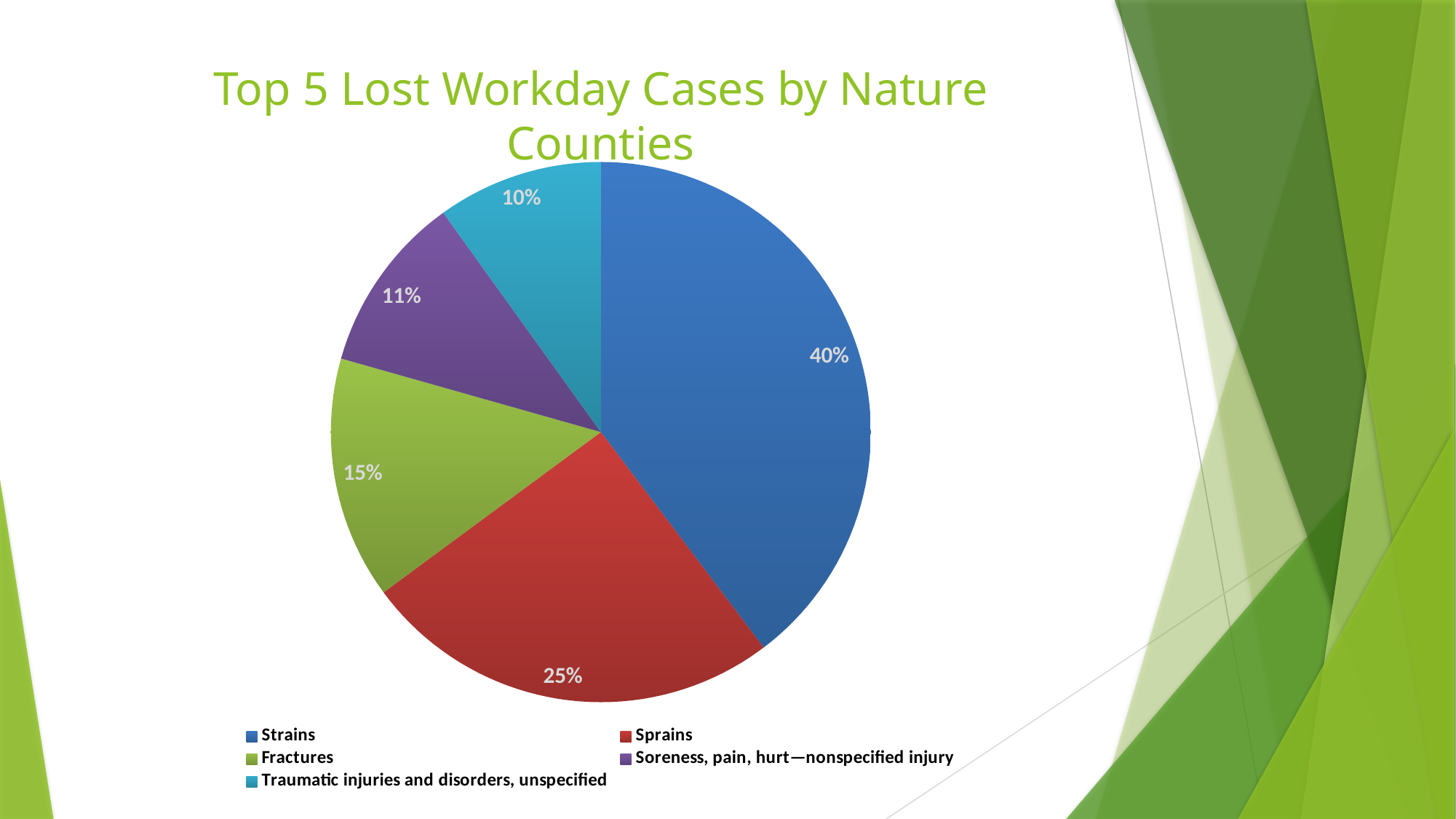
Which category has the largest share of the pie? Strains What is the title of the chart? Top 5 Lost Workday Cases by Nature Counties What type of chart is shown on the slide? Pie chart What share of lost workday cases is attributed to Soreness, pain, hurt—nonspecified injury? 11% What share of lost workday cases is attributed to Fractures? 15% How many categories are shown in the pie chart? 5 What share of lost workday cases is attributed to Strains? 40% What share of lost workday cases is attributed to Traumatic injuries and disorders, unspecified? 10% Which category has the smallest share of the pie? Traumatic injuries and disorders, unspecified What share of lost workday cases is attributed to Sprains? 25% Which has a larger share, Fractures or Sprains? Sprains What is the difference in percentage points between Strains and Sprains? 15